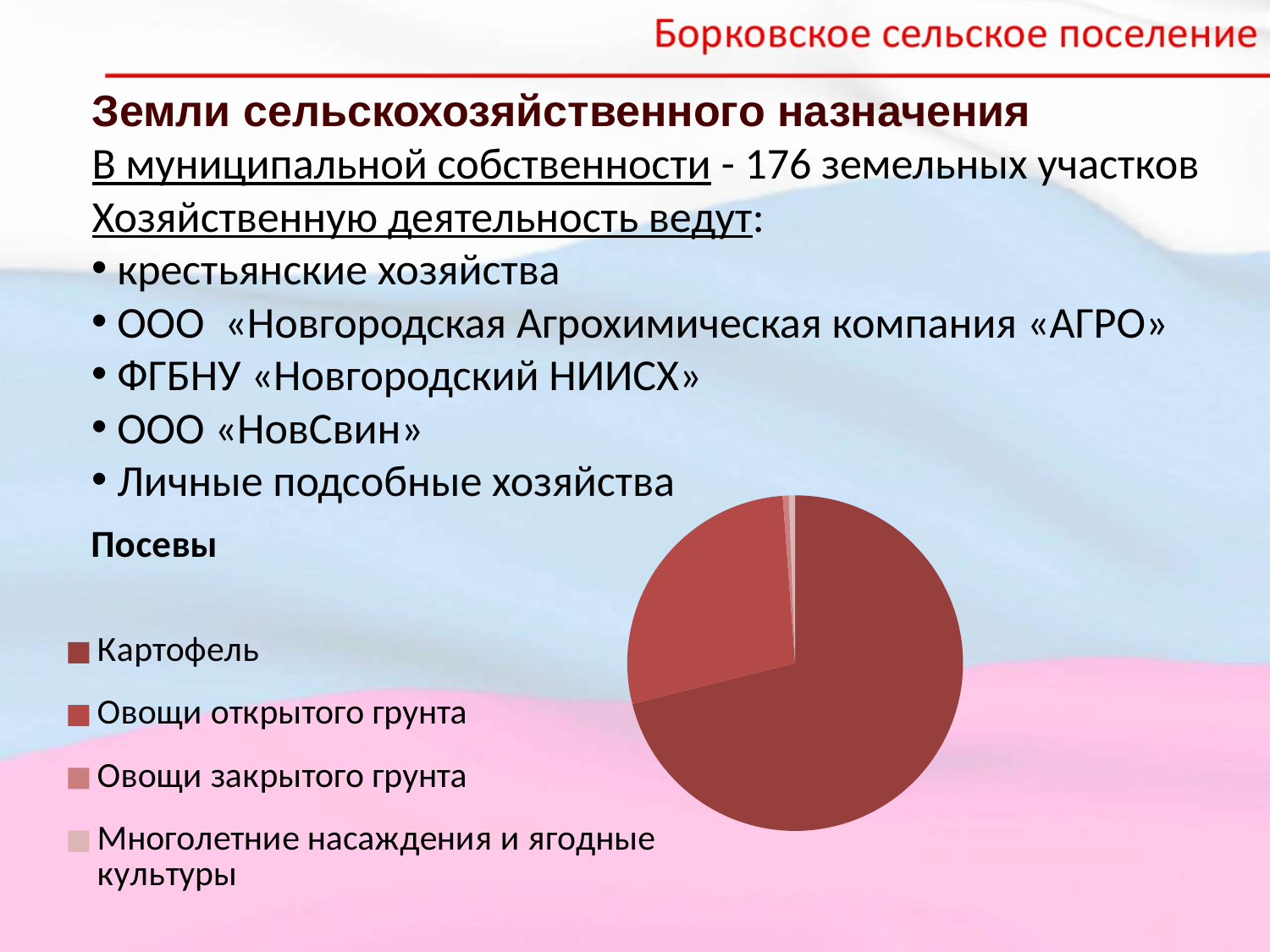
In the "Посевы" pie chart, which slice is larger: Овощи открытого грунта or Многолетние насаждения и ягодные культуры? Овощи открытого грунта How many categories does the legend of the "Посевы" pie chart list? 4 Does the Картофель slice take up more or less than half of the "Посевы" pie chart? more Which legend entry in the "Посевы" pie chart is listed last? Многолетние насаждения и ягодные культуры What is the title of the pie chart on the slide? Посевы Which category has the largest slice in the "Посевы" pie chart? Картофель Which category in the "Посевы" pie chart has the second-largest slice? Овощи открытого грунта In the "Посевы" pie chart, which slice is larger: Картофель or Овощи открытого грунта? Картофель What kind of chart is shown on the slide under the heading "Посевы"? pie chart